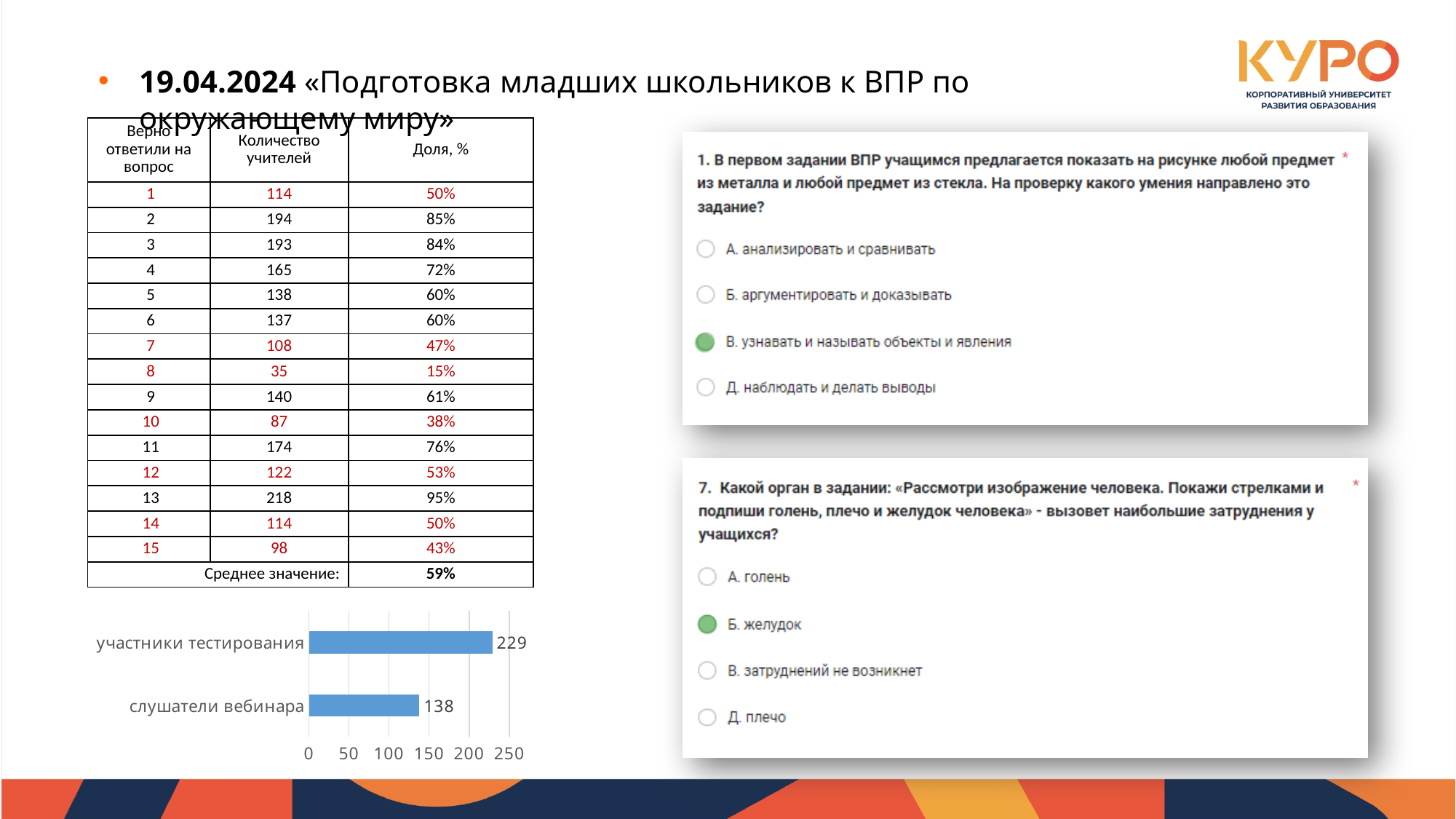
Is the value for участники тестирования in the bar chart greater or less than 200? greater Which category in the bar chart has the lowest value? слушатели вебинара Which category in the bar chart has the highest value? участники тестирования What is the difference between the values for участники тестирования and слушатели вебинара in the bar chart? 91 What colour are the bars in the bar chart? blue What kind of chart is shown at the bottom left of the slide? bar chart What is the value for участники тестирования in the bar chart? 229 What is the maximum value shown on the axis of the bar chart? 250 Is the value for слушатели вебинара in the bar chart greater or less than 150? less How many categories are shown in the bar chart? 2 What is the value for слушатели вебинара in the bar chart? 138 In the bar chart, which is larger: участники тестирования or слушатели вебинара? участники тестирования